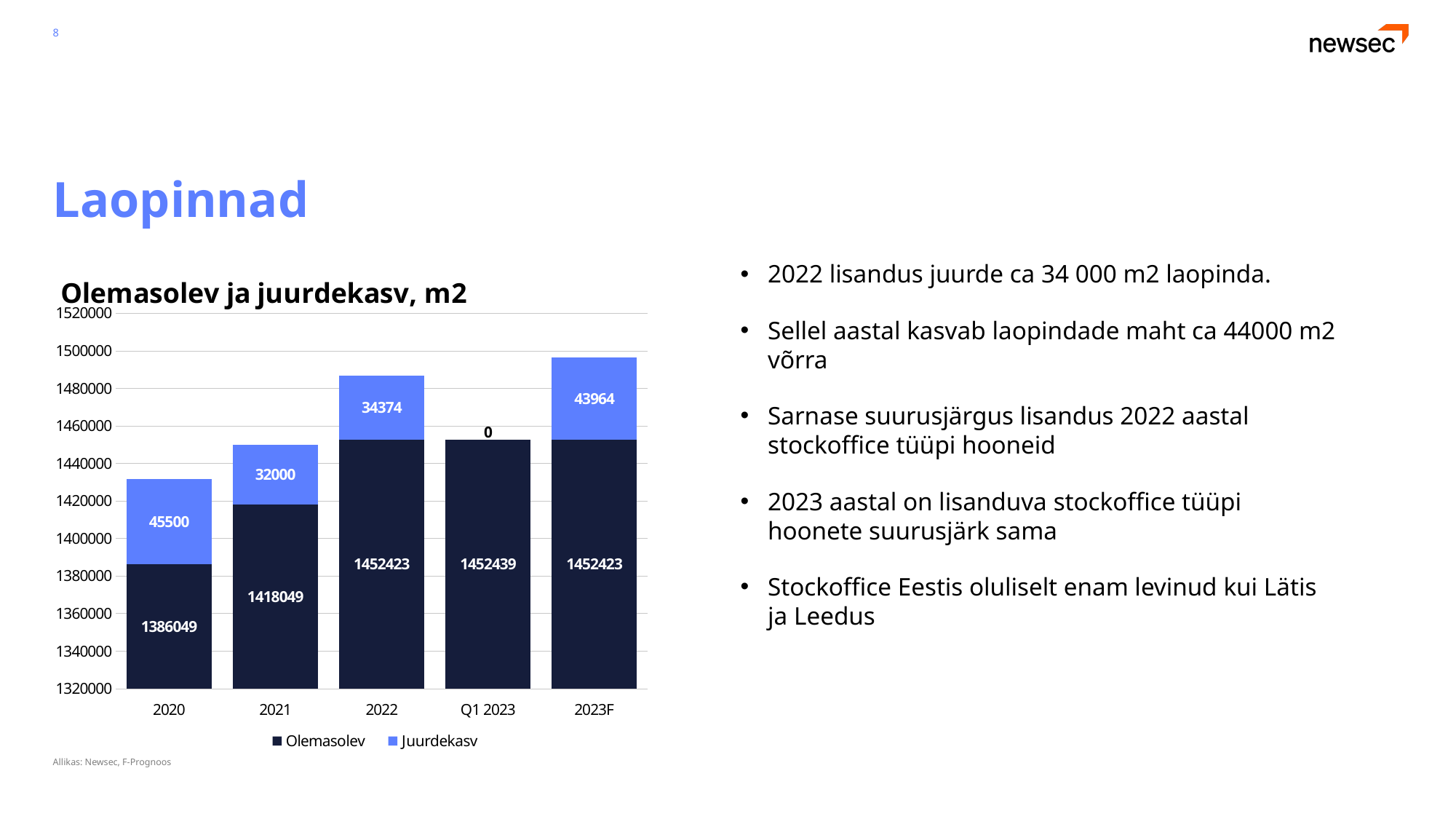
Which category has the lowest Olemasolev value? 2020 Which is larger, the Juurdekasv value for 2022 or for 2023F? 2023F What is the difference between the Juurdekasv values for 2020 and 2021? 13500 What is the total of the stacked bar for 2021? 1450049 What is the Juurdekasv value for Q1 2023? 0 Which category has the highest Juurdekasv value? 2020 What is the Olemasolev value for 2020? 1386049 How many series does the legend list? 2 What kind of chart is shown on the slide? Stacked bar chart What is the Juurdekasv value for 2023F? 43964 How many categories are shown on the x axis? 5 What is the total of the stacked bar for 2023F? 1496387